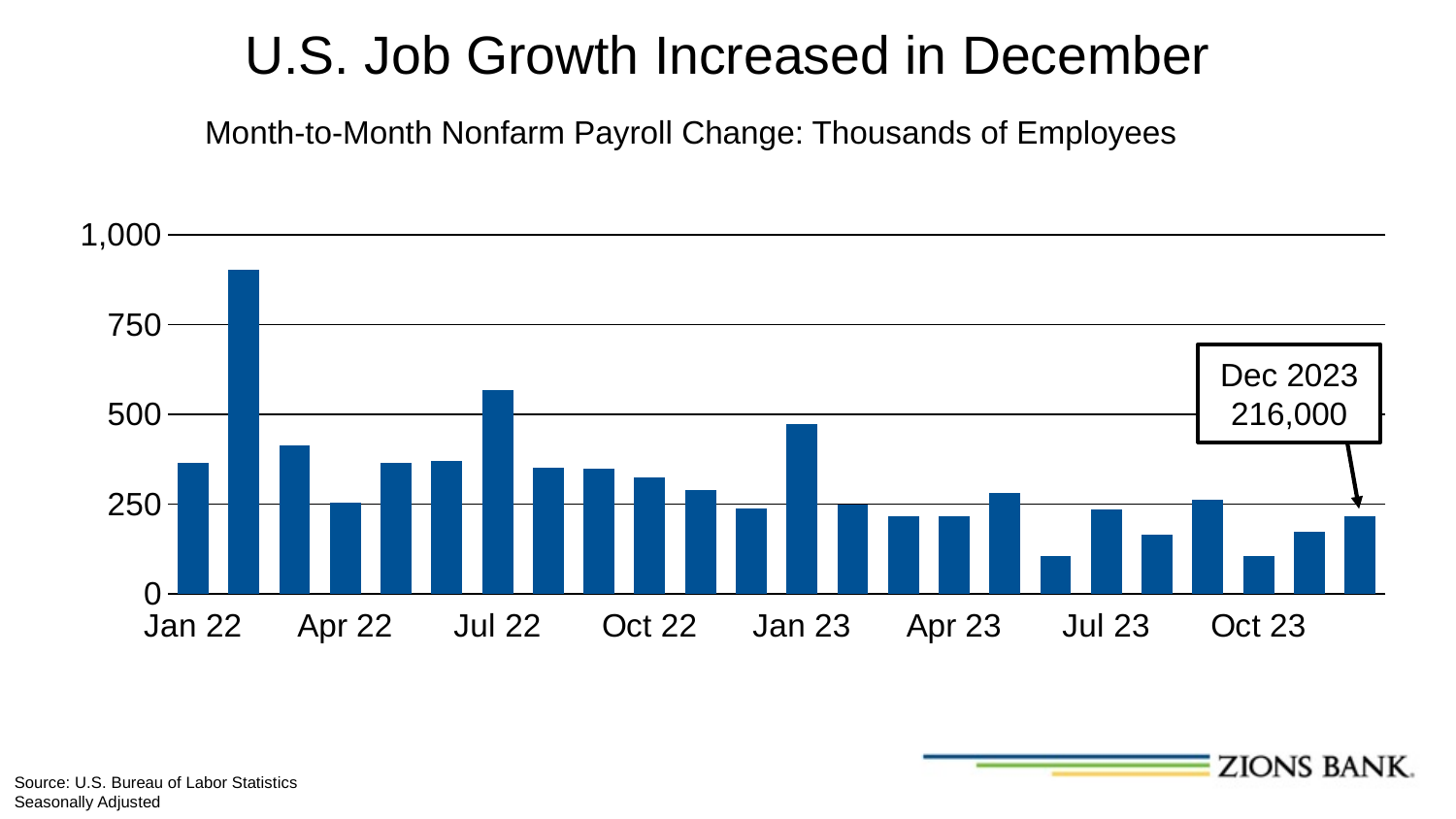
Is the value for Jul 22 greater or less than 500? greater What is the subtitle of the chart? Month-to-Month Nonfarm Payroll Change: Thousands of Employees Is the value for Oct 23 greater or less than 250? less What is the value labeled for Dec 2023? 216,000 What kind of chart is shown on the slide? bar chart Which is larger, the value for Jan 22 or the value for Jul 22? Jul 22 Which is larger, the value for Jan 22 or the value for Oct 23? Jan 22 Overall, do the monthly values rise or fall from Jan 22 to Dec 23? fall Is the value for Jan 22 greater or less than 250? greater How many monthly bars are plotted in the chart? 24